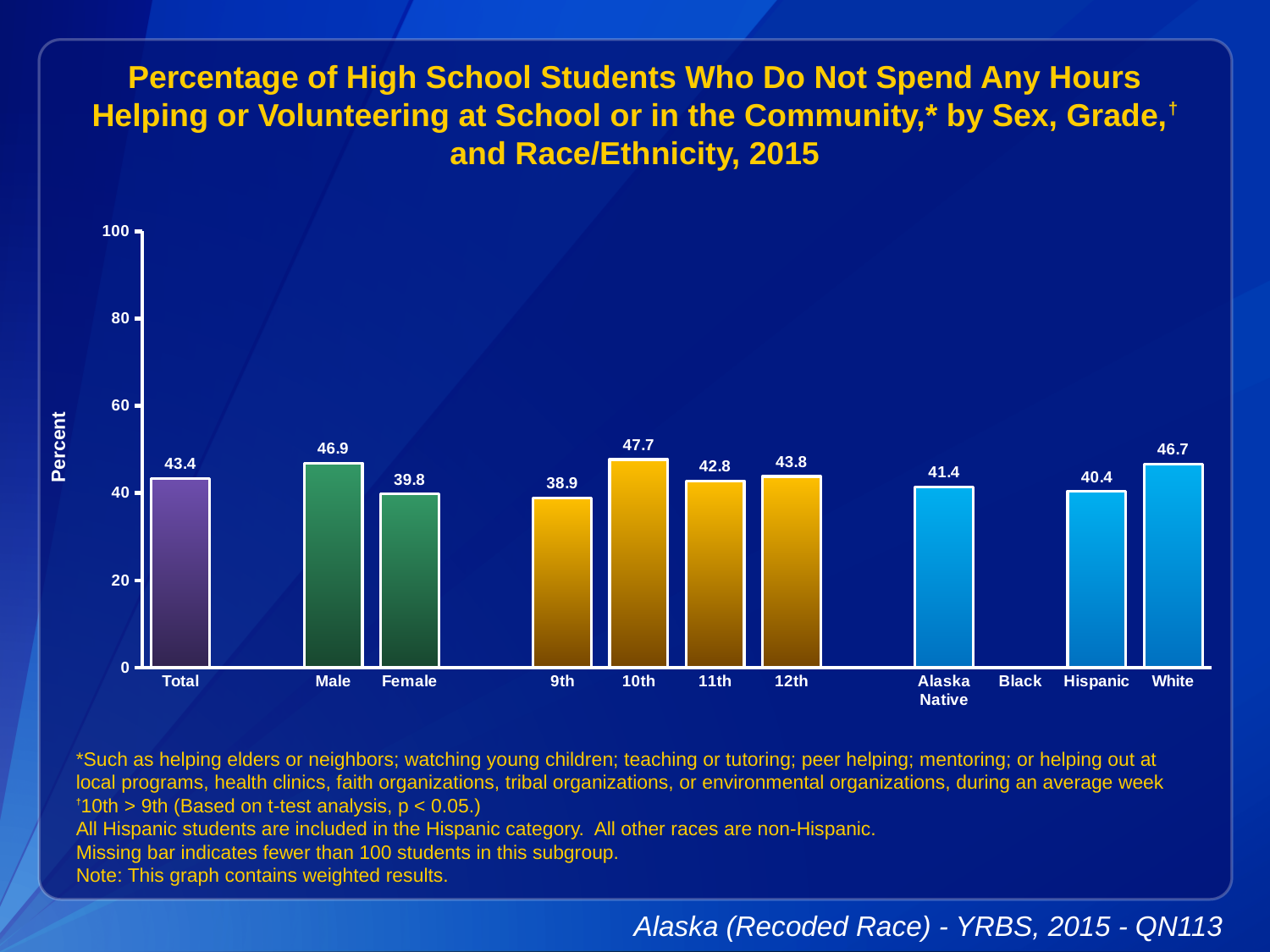
Which category has the lowest value? 9th What is the value for Total? 43.4 Which is larger, the value for Hispanic or the value for White? White What is the difference between the Male and Female values? 7.1 Which category label has no bar shown? Black What is the value for Alaska Native? 41.4 What is the value for Female? 39.8 Which category has the highest value? 10th Is the value for 11th grade greater or less than 40? greater How many bars are plotted on the chart? 10 What is the value for 10th grade? 47.7 What kind of chart is shown? bar chart